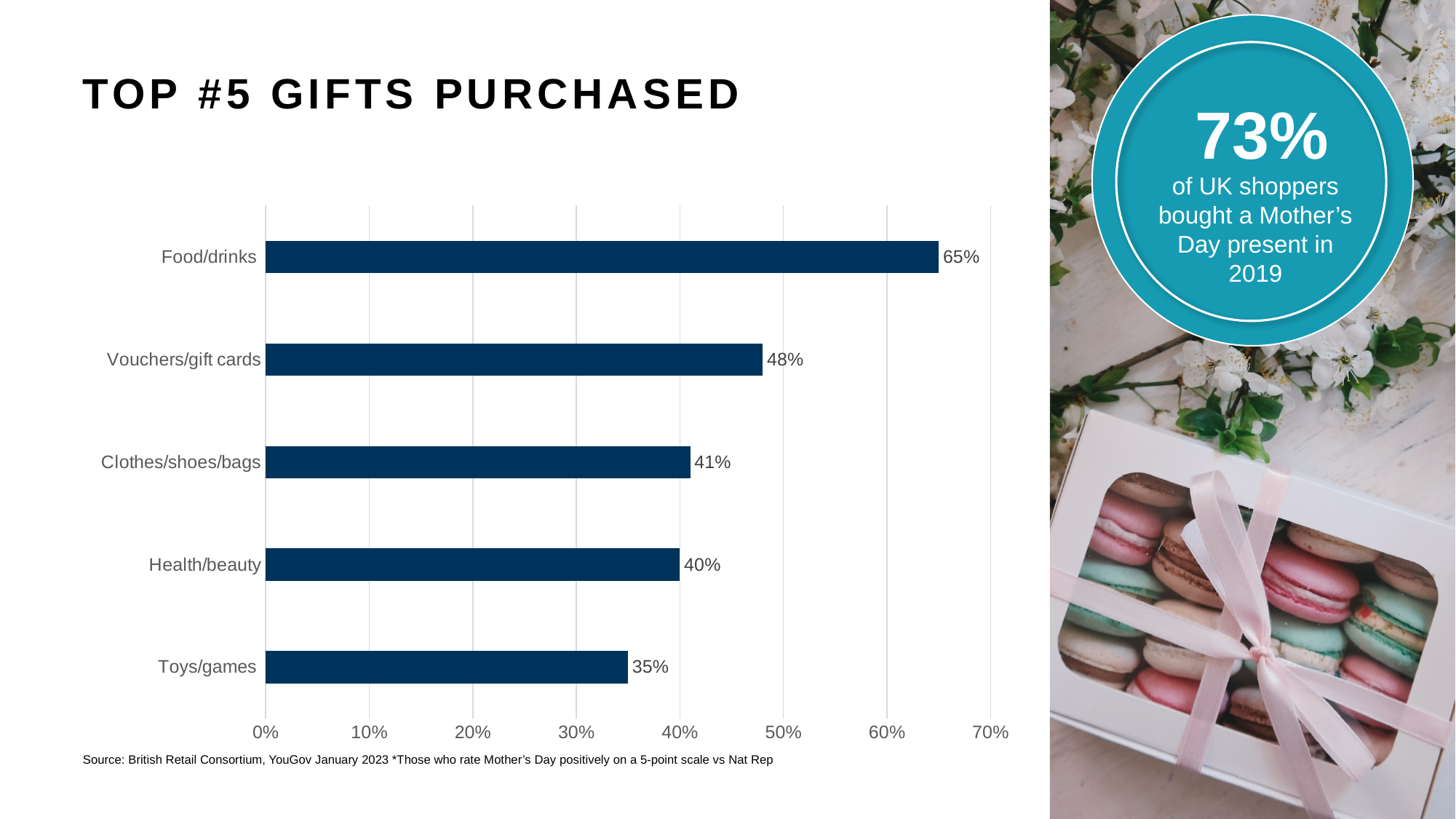
How many categories are shown in the chart? 5 What is the value for Toys/games? 35% Which is larger, the value for Vouchers/gift cards or the value for Health/beauty? Vouchers/gift cards What kind of chart is shown on the slide? Bar chart What is the value for Food/drinks? 65% Which category has the highest value? Food/drinks What is the difference between the values for Food/drinks and Vouchers/gift cards? 17% Which category has the lowest value? Toys/games What is the difference between the values for Clothes/shoes/bags and Toys/games? 6% What is the value for Vouchers/gift cards? 48% What is the value for Health/beauty? 40% What is the title of the chart? TOP #5 GIFTS PURCHASED